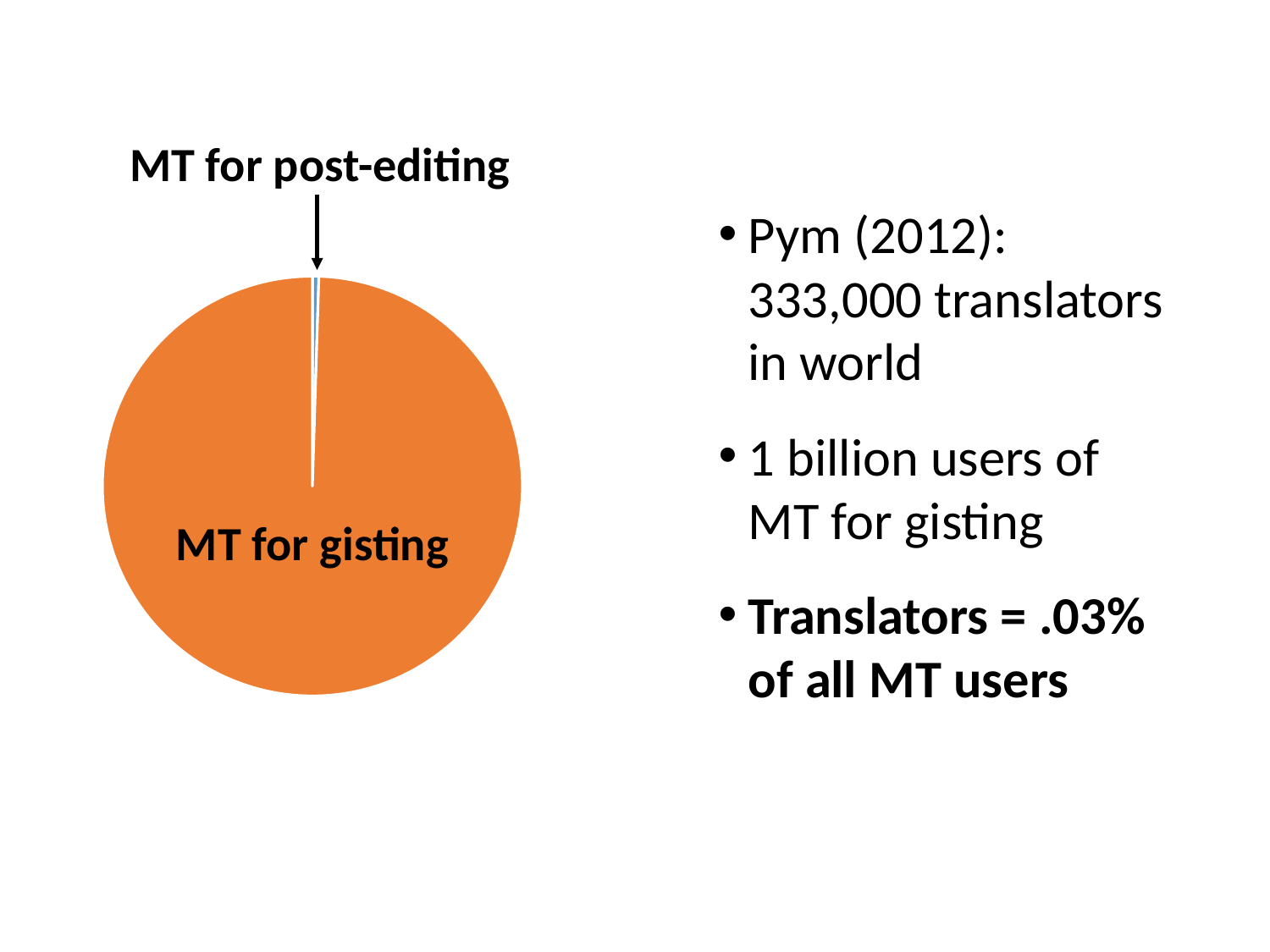
Which slice of the pie chart does the arrow point to? MT for post-editing Which slice of the pie chart is the largest? MT for gisting What kind of chart is shown on the slide? pie chart Which slice of the pie chart is the smallest? MT for post-editing Which is larger in the pie chart, MT for gisting or MT for post-editing? MT for gisting What colour is the MT for gisting slice of the pie chart? orange How many slices does the pie chart have? 2 Does the MT for gisting slice take up more or less than half of the pie chart? more